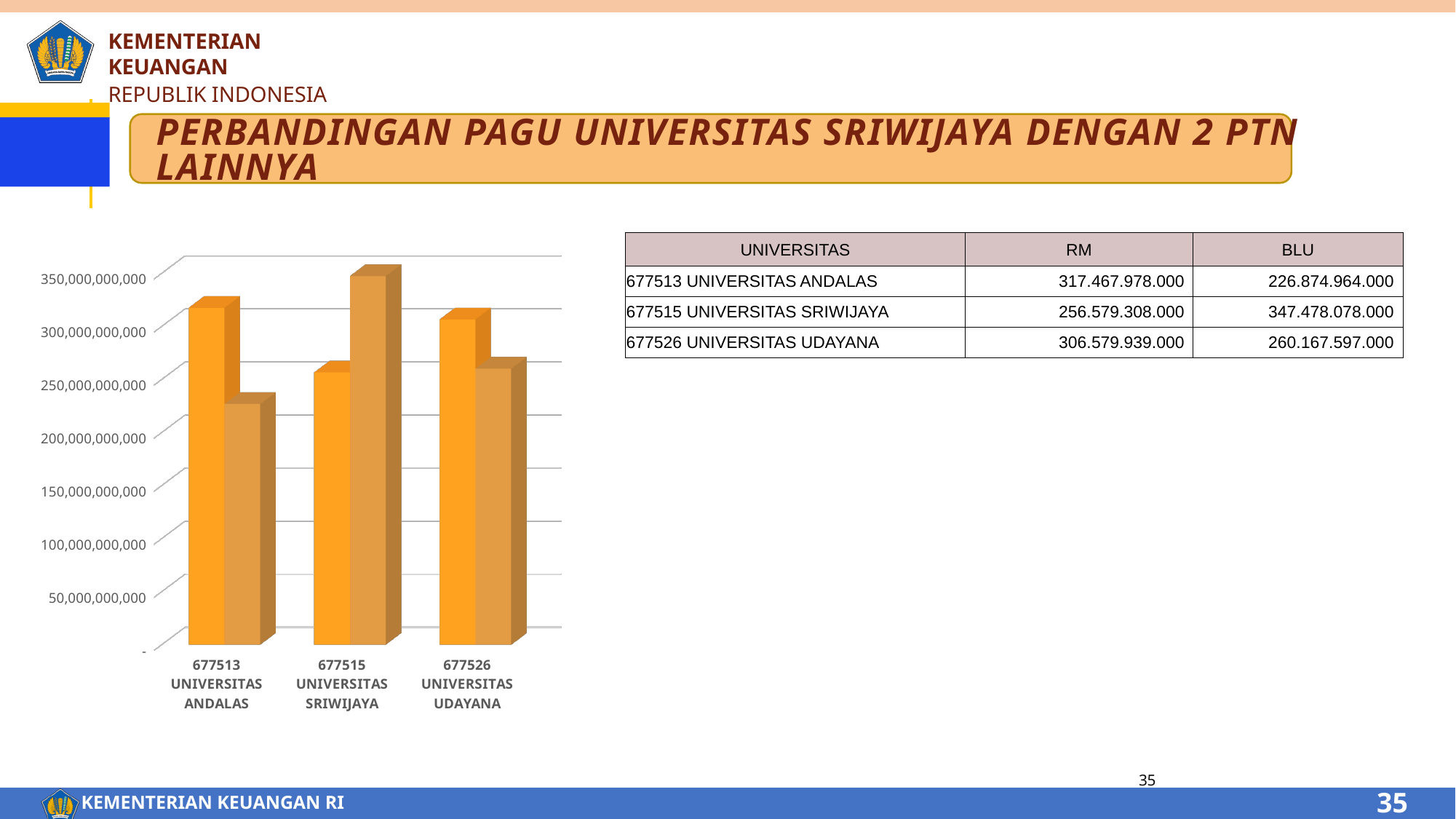
Which university has the tallest bar on the chart? 677515 UNIVERSITAS SRIWIJAYA Using the values in the table, what is the difference between the BLU and RM values for 677515 UNIVERSITAS SRIWIJAYA? 90.898.770.000 For 677526 UNIVERSITAS UDAYANA, which is larger, the RM bar or the BLU bar? RM According to the table accompanying the chart, what is the BLU value for 677515 UNIVERSITAS SRIWIJAYA? 347.478.078.000 Is the second (BLU) bar for 677513 UNIVERSITAS ANDALAS greater or less than 250,000,000,000? less How many universities are shown as categories on the chart? 3 Is the first (RM) bar for 677513 UNIVERSITAS ANDALAS greater or less than 300,000,000,000? greater Is the first (RM) bar for 677515 UNIVERSITAS SRIWIJAYA greater or less than 300,000,000,000? less According to the table accompanying the chart, what is the RM value for 677526 UNIVERSITAS UDAYANA? 306.579.939.000 Which university has the shortest bar on the chart? 677513 UNIVERSITAS ANDALAS What kind of chart is shown on the slide? bar chart